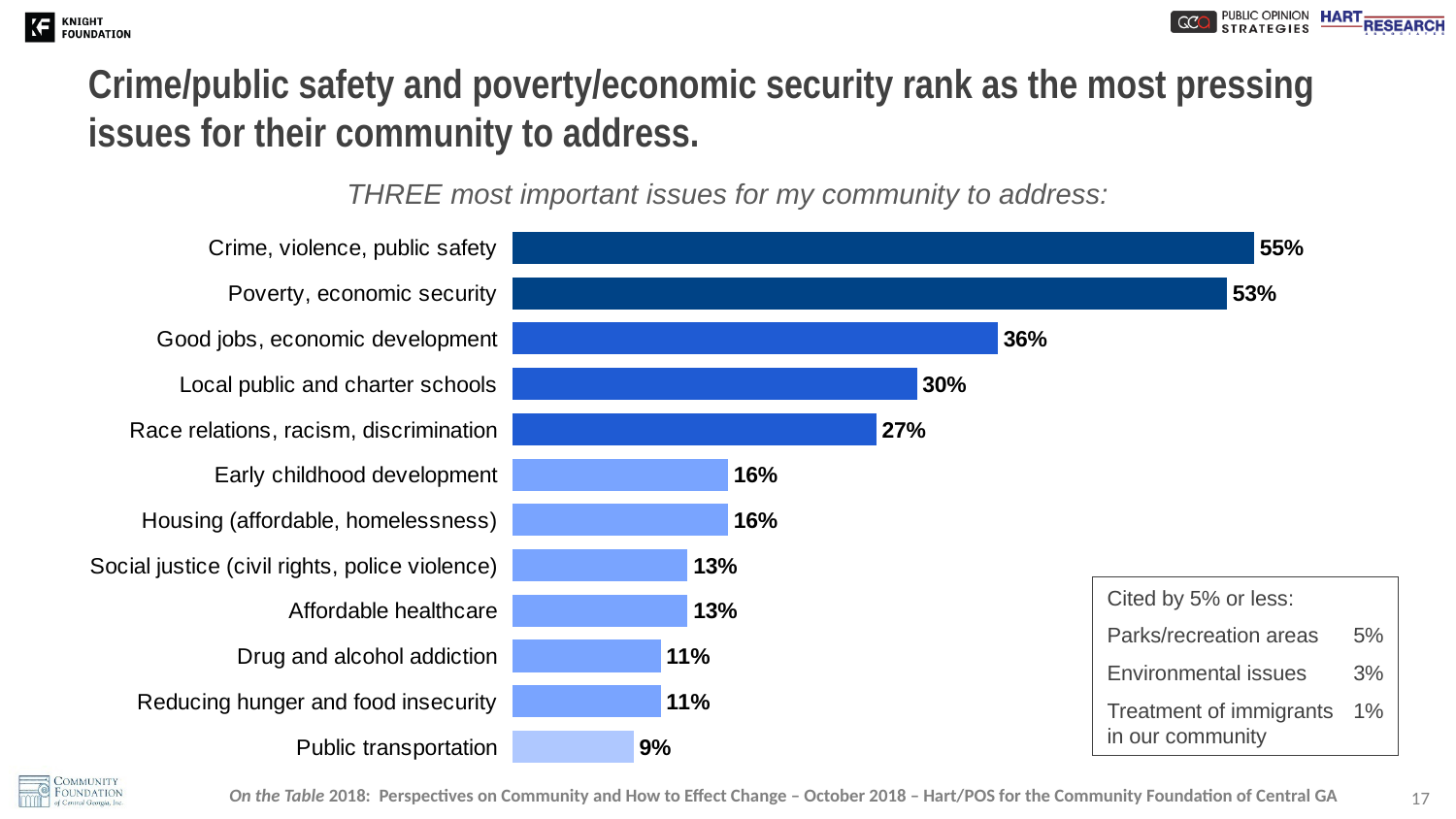
Which issue has the lowest percentage among the bars plotted in the chart? Public transportation What percentage of respondents cited crime, violence, public safety as one of the three most important issues? 55% What percentage is listed for Environmental issues in the 'Cited by 5% or less' box? 3% How many issues are plotted as bars in the chart? 12 Which issue has the highest percentage in the chart? Crime, violence, public safety What type of chart is shown on the slide? Bar chart What is the subtitle of the chart shown above the bars? THREE most important issues for my community to address: What value is shown for Local public and charter schools? 30% What percentage is shown for Public transportation? 9% What is the difference in percentage points between Crime, violence, public safety and Poverty, economic security? 2 Which has a higher value: Poverty, economic security or Good jobs, economic development? Poverty, economic security What is the difference in percentage points between Good jobs, economic development and Race relations, racism, discrimination? 9